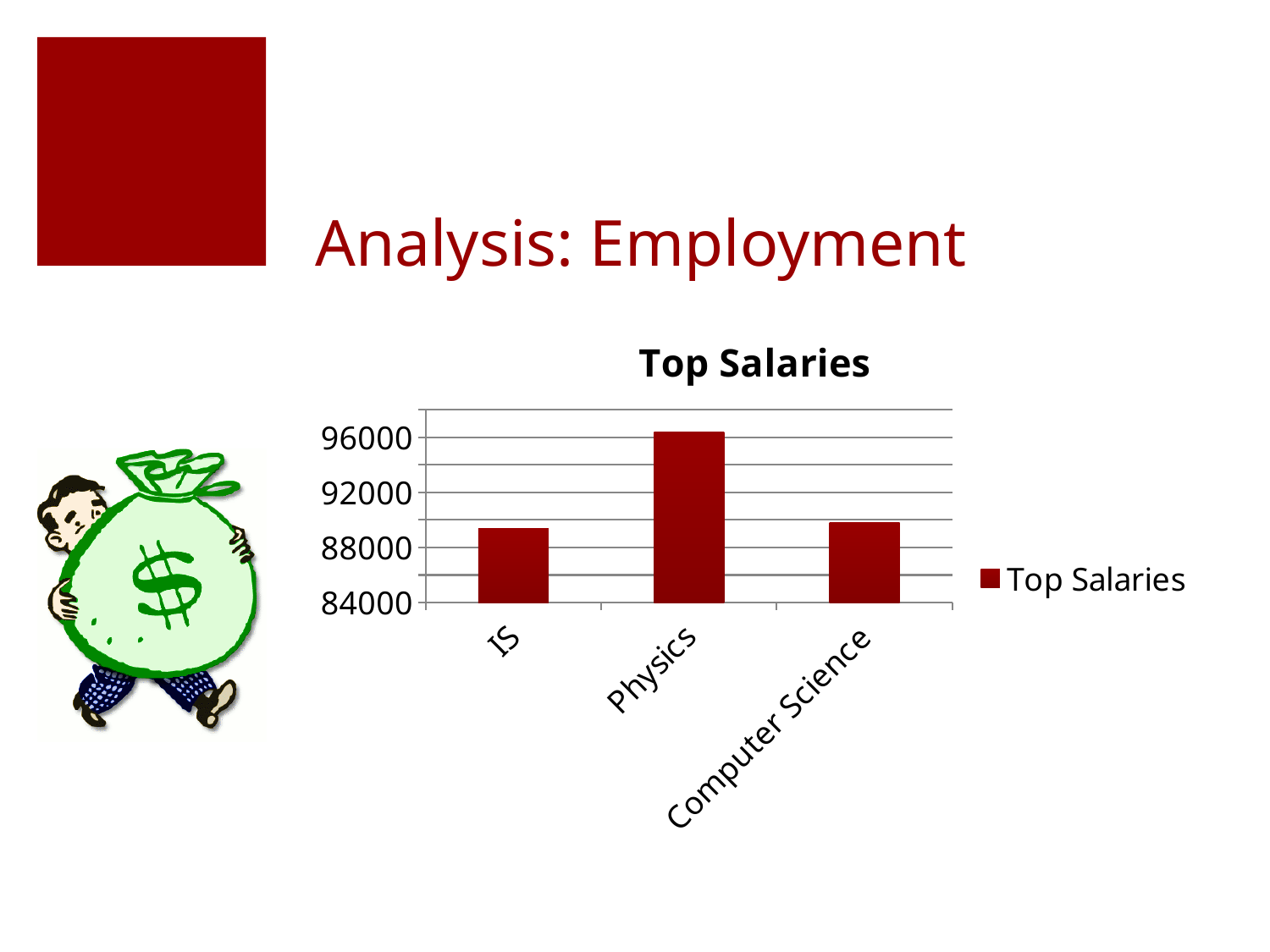
What kind of chart is shown on the slide? bar chart Is the value for Computer Science greater or less than 92000? less How many categories are shown on the x axis of the chart? 3 What is the title of the chart? Top Salaries Is the value for IS greater or less than 88000? greater Which is larger, the top salary for Physics or for IS? Physics Is the value for Physics greater or less than 92000? greater Which is larger, the top salary for Physics or for Computer Science? Physics How many series does the legend list? 1 What is the name of the series shown in the legend? Top Salaries Which category has the highest top salary? Physics